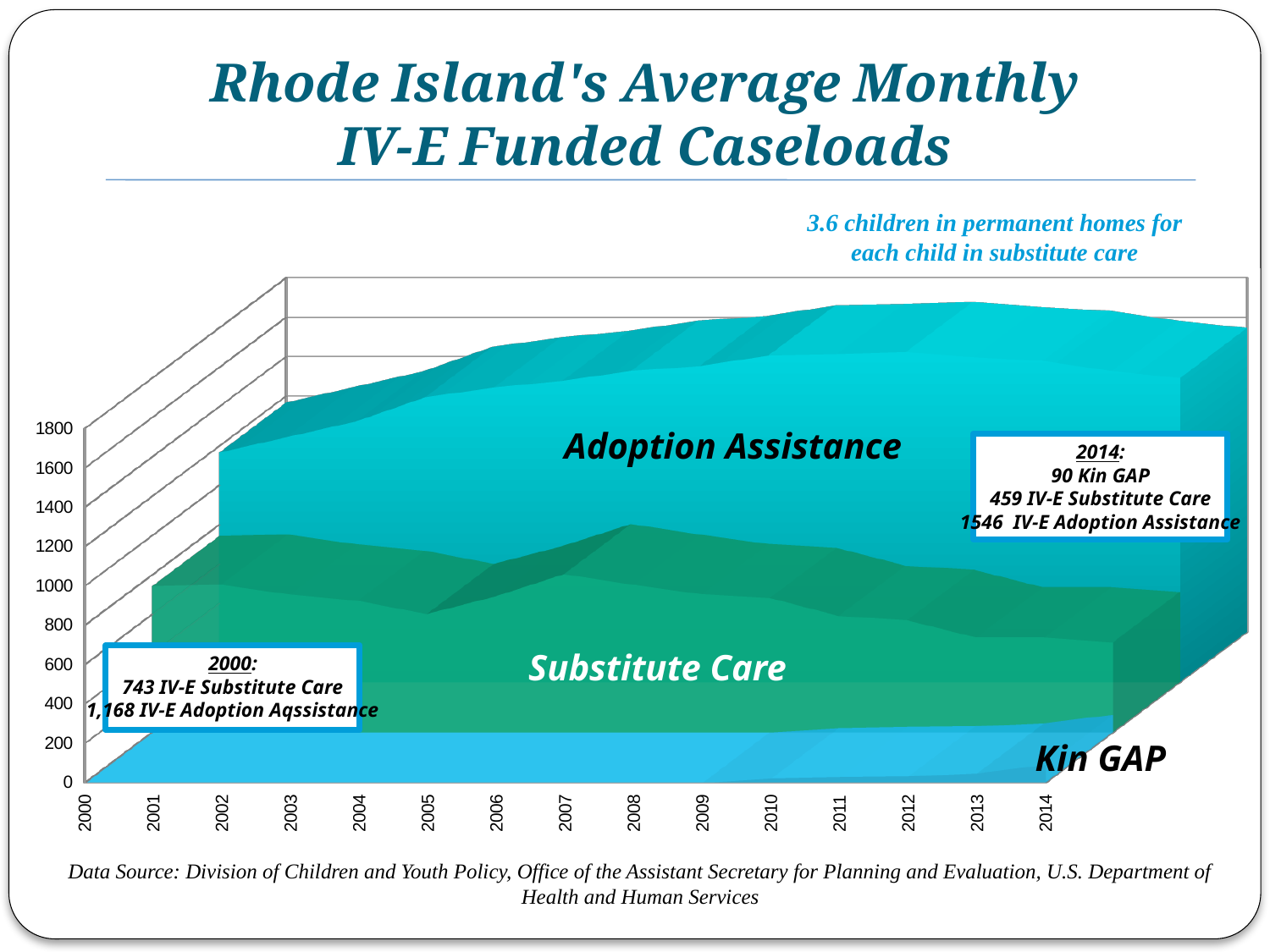
By how much did the IV-E Adoption Assistance caseload increase from 2000 to 2014? 378 What was the IV-E Adoption Assistance caseload in 2000? 1,168 What was the IV-E Substitute Care caseload in 2000? 743 How many years are shown on the x axis of the chart? 15 Does the Substitute Care caseload rise or fall from 2000 to 2014? Fall How many caseload categories are labeled on the chart? 3 What was the Kin GAP caseload in 2014? 90 By how much did the IV-E Substitute Care caseload decrease from 2000 to 2014? 284 What kind of chart is shown on the slide? Area chart In 2014, which was larger: the IV-E Substitute Care caseload or the IV-E Adoption Assistance caseload? IV-E Adoption Assistance What was the IV-E Adoption Assistance caseload in 2014? 1546 What was the IV-E Substitute Care caseload in 2014? 459